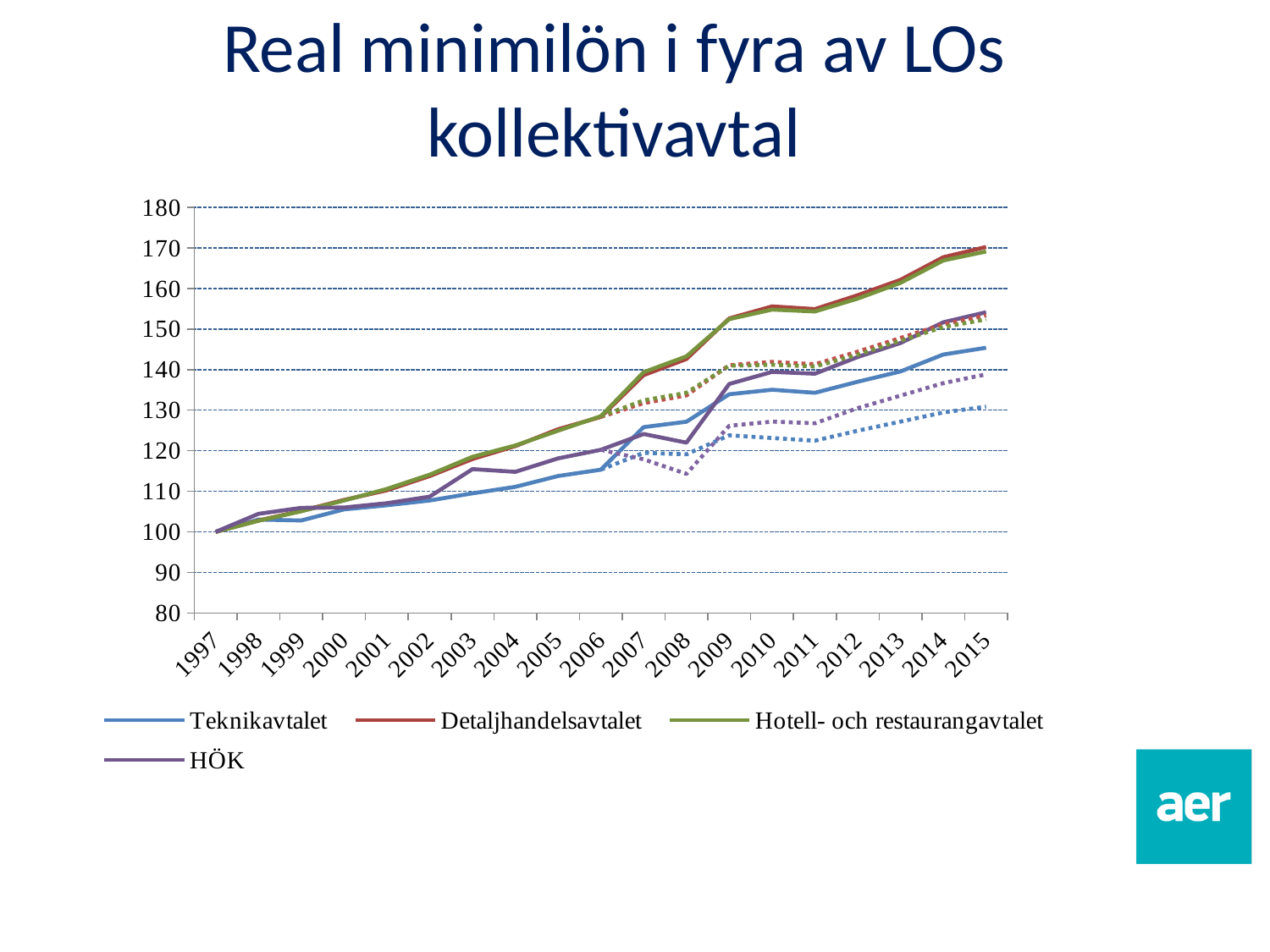
How many years are shown along the x axis? 19 Is the value for Teknikavtalet in 2015 greater or less than 140? greater Which is larger in 2015, Detaljhandelsavtalet or Teknikavtalet? Detaljhandelsavtalet Do the values for Detaljhandelsavtalet generally rise or fall from 1997 to 2015? rise Which of the four legend series has the lowest value in 2015? Teknikavtalet Is the value for Detaljhandelsavtalet in 2015 greater or less than 160? greater Is the value for Teknikavtalet in 2011 greater or less than 140? less What is the title of the chart? Real minimilön i fyra av LOs kollektivavtal How many series does the legend list? 4 What kind of chart is shown on the slide? line chart What is the value of Teknikavtalet in 1997? 100